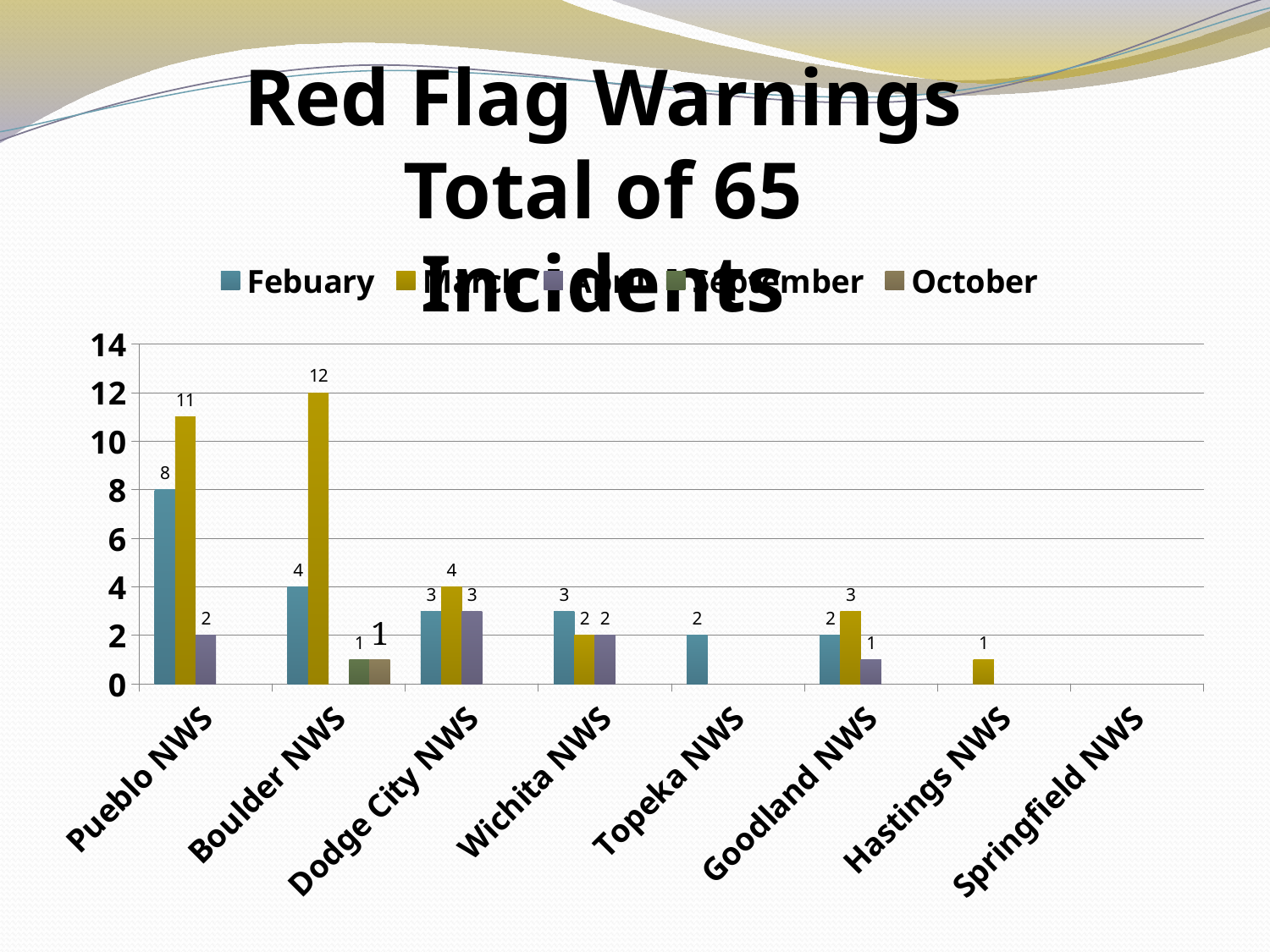
Which is larger, the Febuary value for Dodge City NWS or the Febuary value for Goodland NWS? Dodge City NWS What is the difference between the March value for Pueblo NWS and the March value for Boulder NWS? 1 What is the March value for Boulder NWS? 12 What is the Febuary value for Pueblo NWS? 8 What is the difference between the Febuary and March values for Pueblo NWS? 3 Which NWS office has the highest Febuary value? Pueblo NWS How many NWS offices are listed along the x axis? 8 How many series does the legend list? 5 What type of chart is shown on the slide? bar chart Which NWS office has the highest March value? Boulder NWS What is the March value for Hastings NWS? 1 What is the Febuary value for Topeka NWS? 2